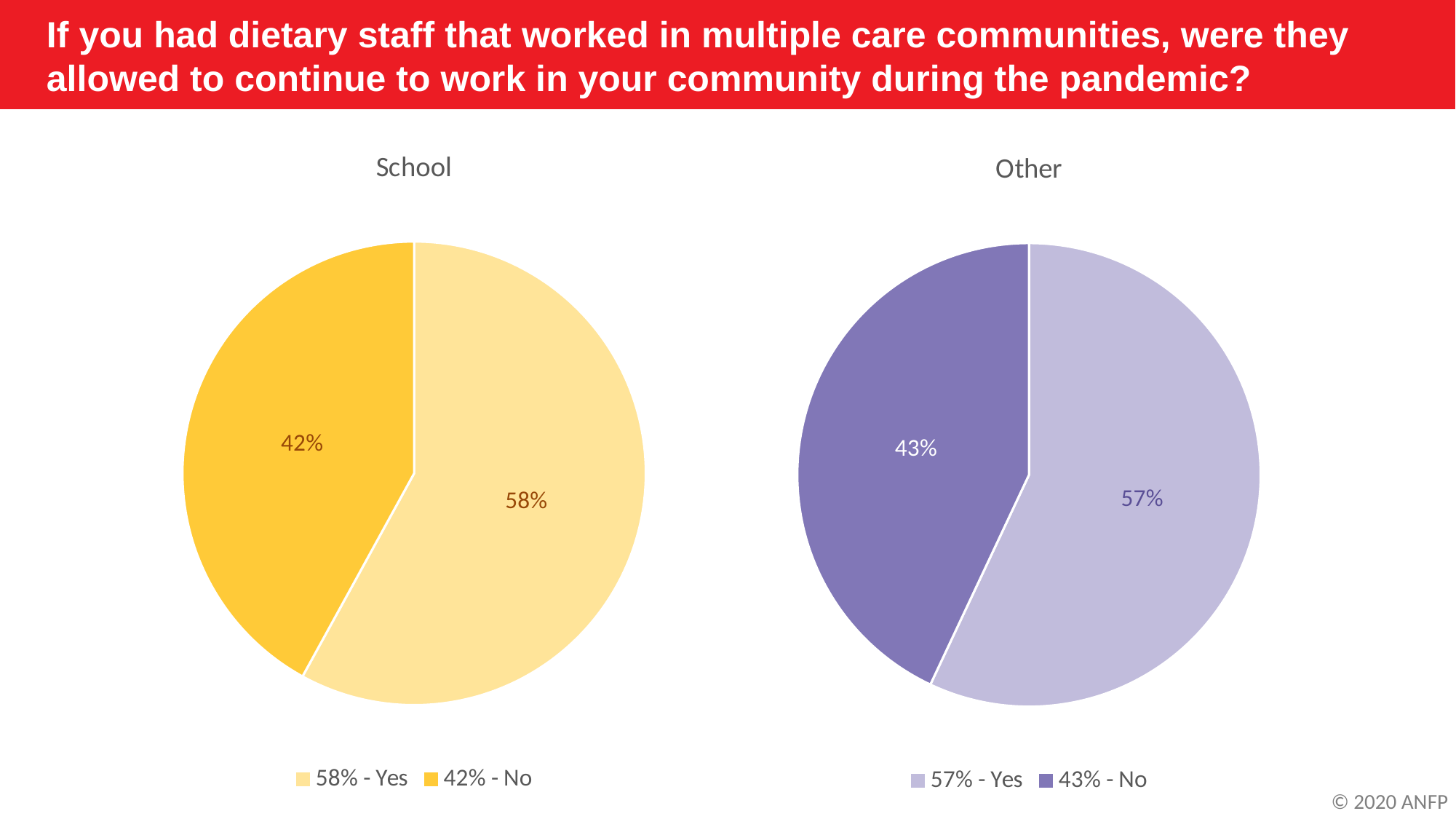
How many charts are shown on the slide? 2 Is the Yes share larger in the School chart or the Other chart? School What kind of chart is the School chart? Pie chart In the School chart, what percentage answered Yes? 58% In the Other chart, which response has the smaller share? No How many slices does the Other chart have? 2 In the School chart, what is the difference between the Yes and No percentages? 16% In the Other chart, what is the difference between the Yes and No percentages? 14% In the Other chart, what percentage answered No? 43% In the Other chart, what percentage answered Yes? 57% In the School chart, what percentage answered No? 42% In the School chart, which response has the larger share? Yes